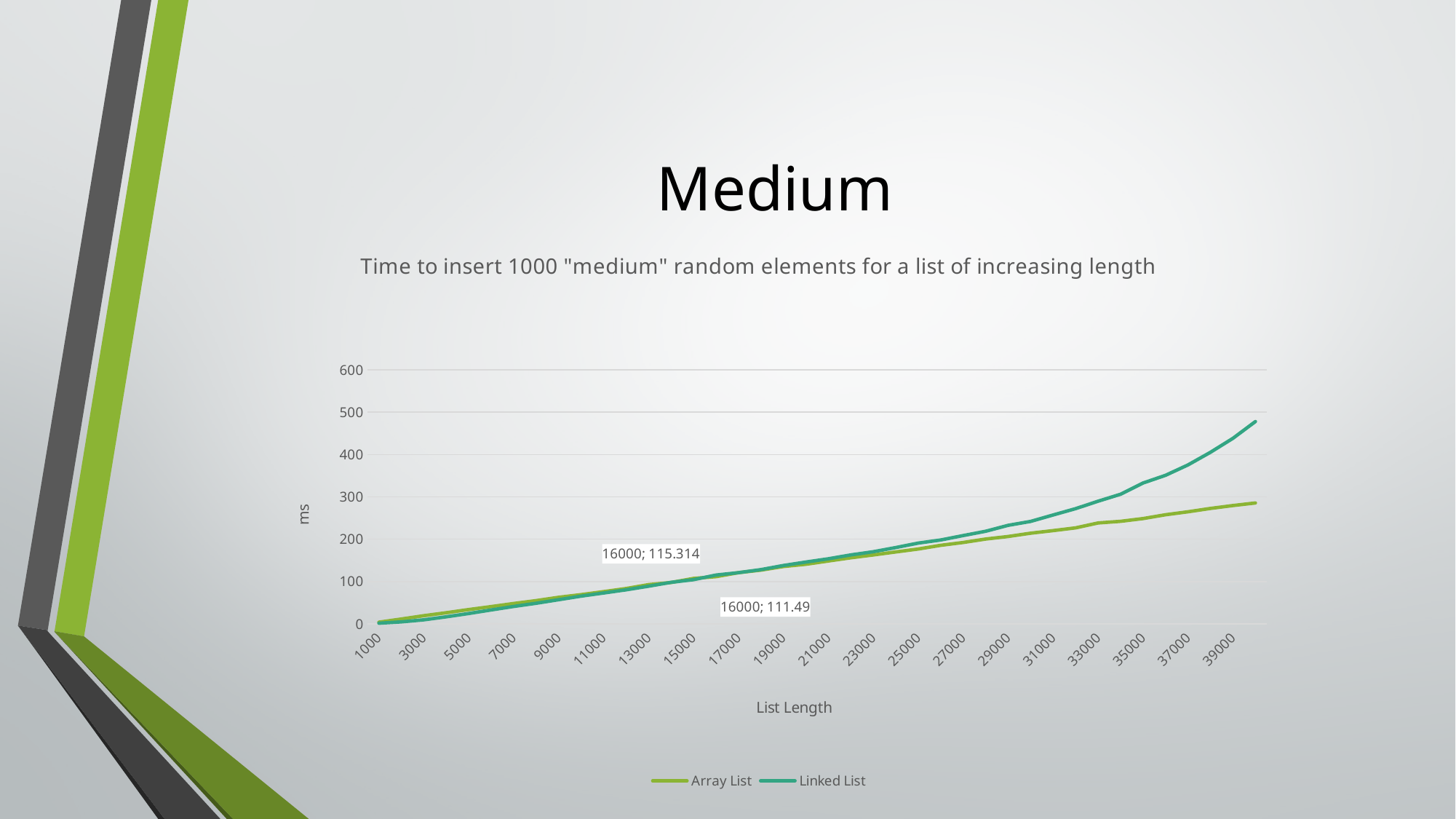
How many list length tick labels are shown on the x axis? 20 Is the Array List value at a list length of 39000 greater or less than 300? less What are the two series named in the legend? Array List and Linked List What is the title of the chart? Time to insert 1000 "medium" random elements for a list of increasing length What kind of chart is shown on the slide? line chart Which series has the higher value at a list length of 39000? Linked List Do the values for Linked List rise or fall as list length increases? rise At which list length are the two data labels on the chart shown? 16000 Is the Linked List value at a list length of 39000 greater or less than 400? greater Do the values for Array List rise or fall as list length increases? rise How many series does the legend list? 2 Is the Linked List value at a list length of 25000 greater or less than 300? less